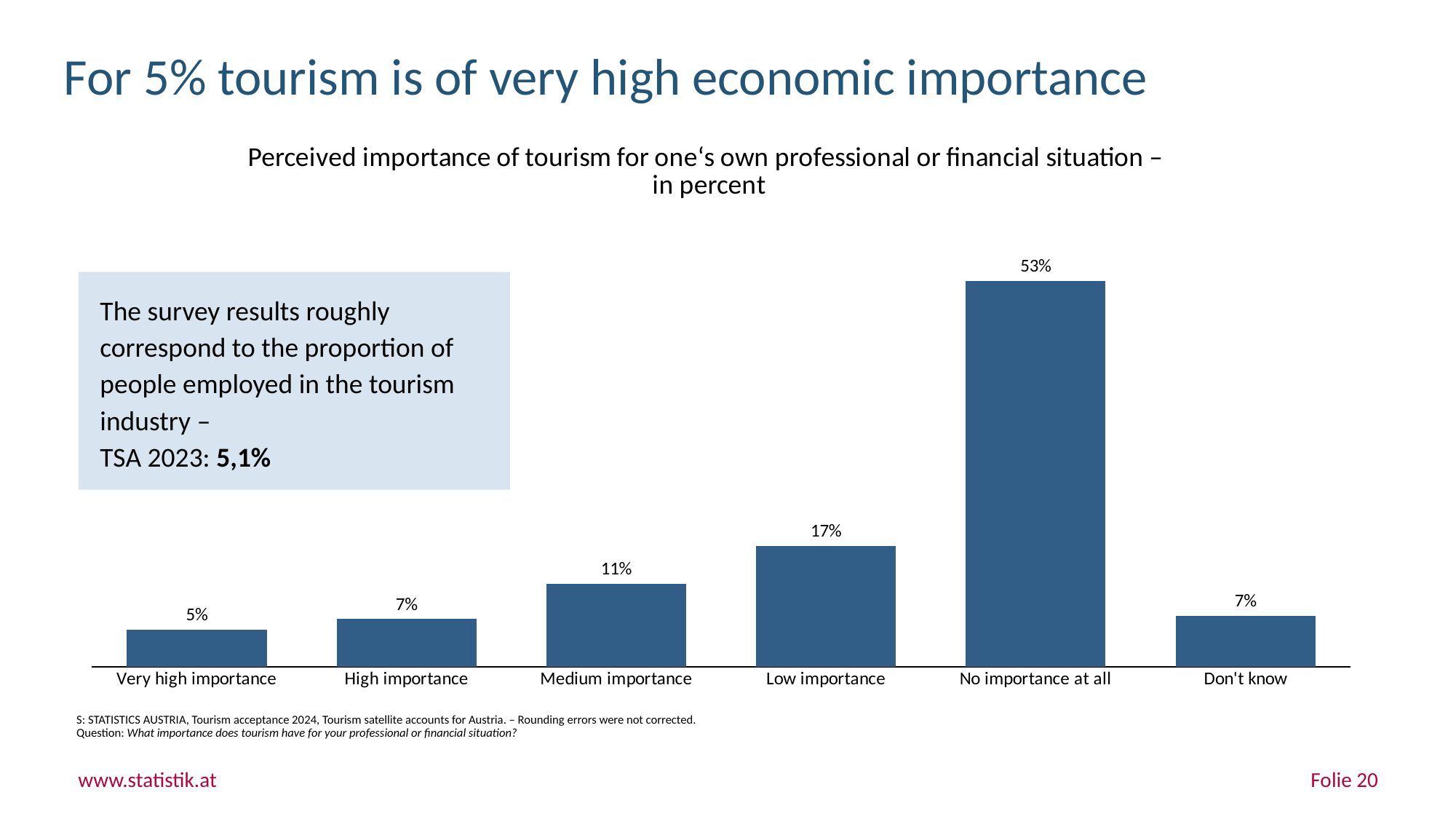
What is the difference between the values for "Medium importance" and "High importance"? 4% What is the value for "Medium importance"? 11% What is the value for "Very high importance"? 5% What is the value for "Low importance"? 17% Which category has the highest value? No importance at all Which category has the lowest value? Very high importance Which is larger, the value for "Low importance" or the value for "Don't know"? Low importance What is the value for "No importance at all"? 53% How many categories are shown on the x axis? 6 What kind of chart is shown on the slide? Bar chart What is the difference between the values for "No importance at all" and "Low importance"? 36% What is the title of the chart? Perceived importance of tourism for one's own professional or financial situation – in percent